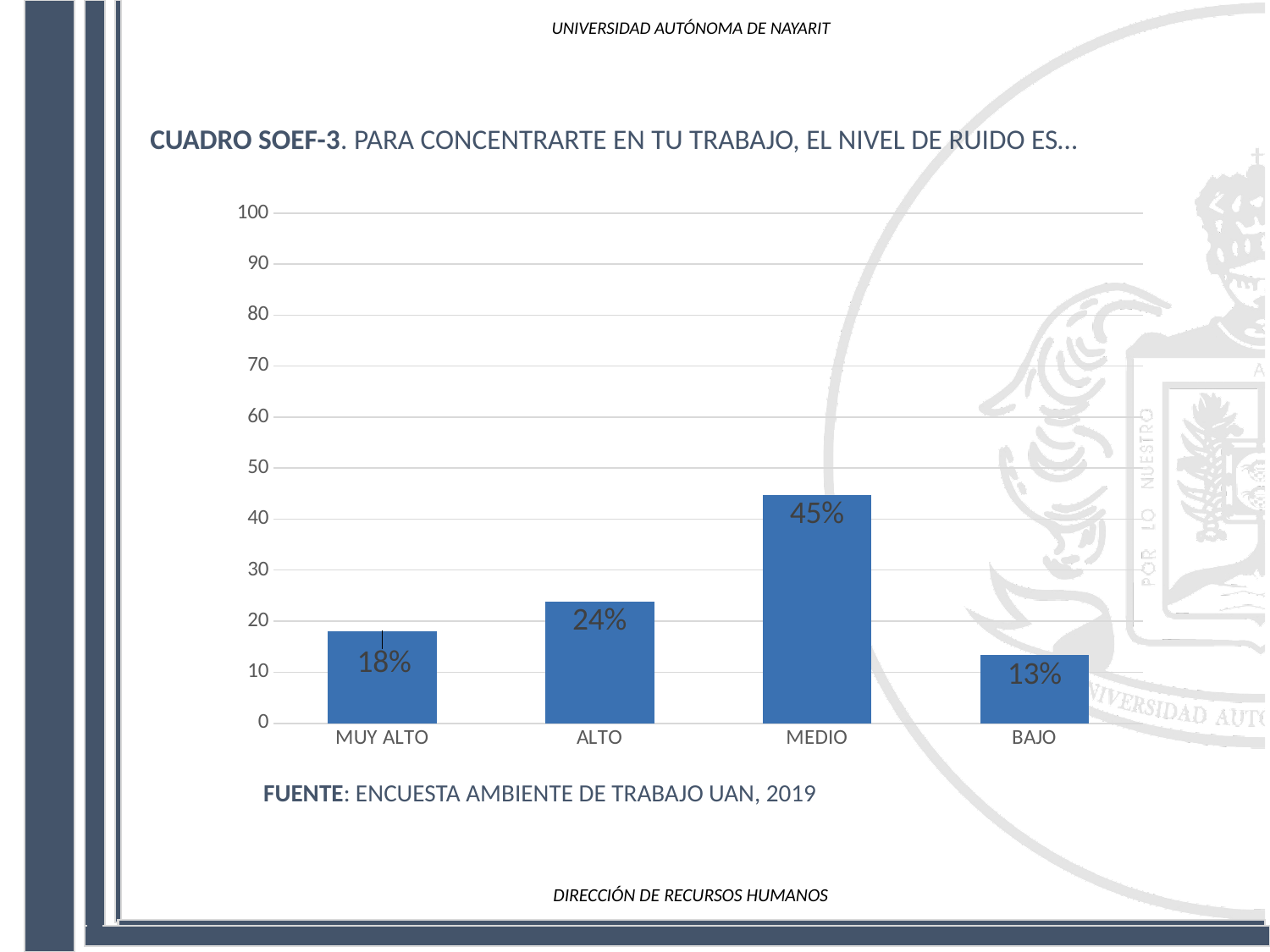
What is the value for MUY ALTO? 18% Which category has the highest value? MEDIO How many categories are shown on the x axis? 4 What is the value for BAJO? 13% Which is larger, the value for ALTO or the value for MUY ALTO? ALTO Is the value for MEDIO greater or less than 40? greater What is the maximum value shown on the y axis? 100 What is the value for MEDIO? 45% What kind of chart is shown on the slide? bar chart What is the source cited below the chart? ENCUESTA AMBIENTE DE TRABAJO UAN, 2019 Which category has the lowest value? BAJO What is the difference between the values for MEDIO and ALTO? 21%